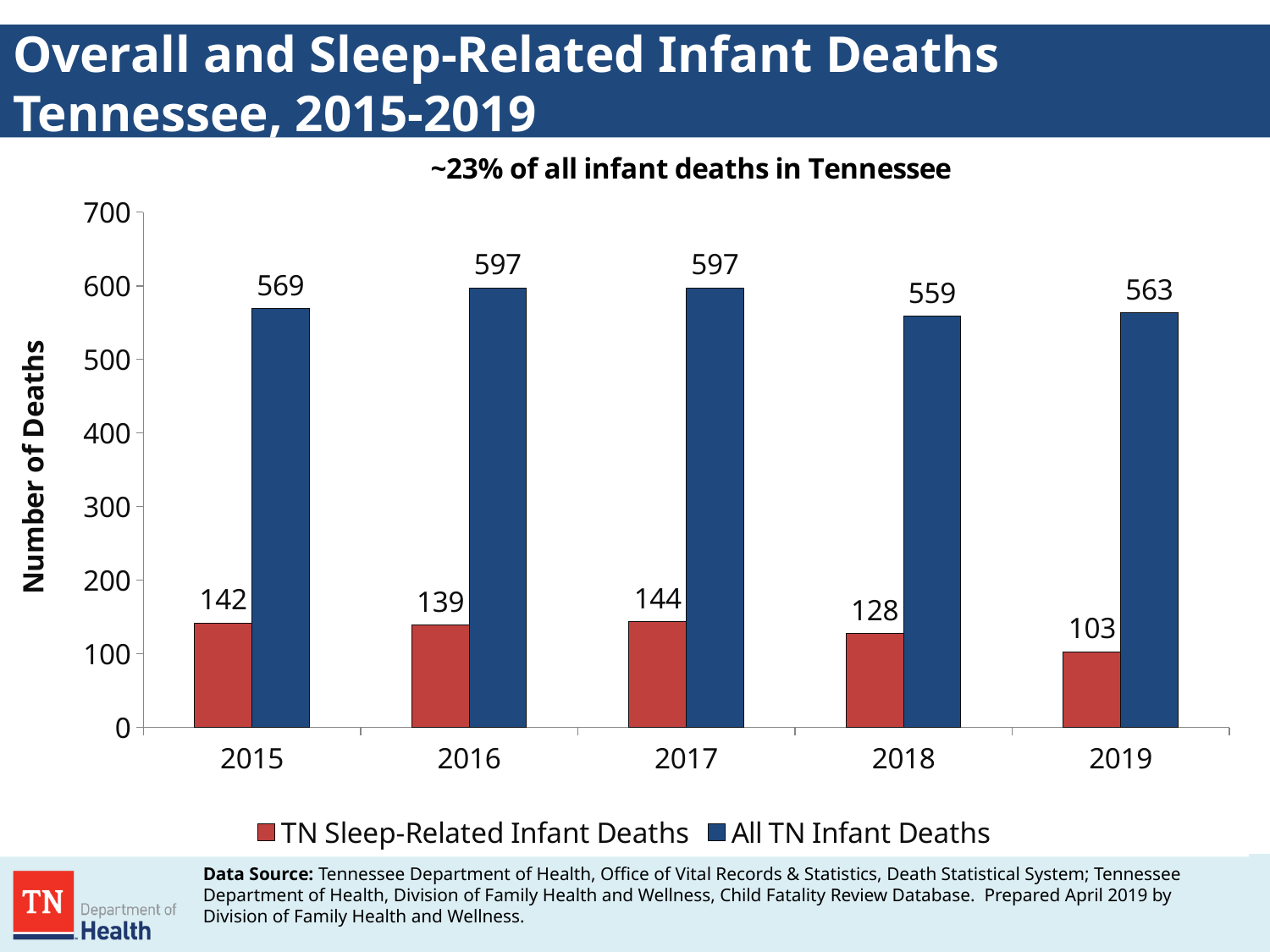
What is the value for TN Sleep-Related Infant Deaths in 2017? 144 Which year has the lowest value for All TN Infant Deaths? 2018 What is the label of the y axis? Number of Deaths Which is larger, All TN Infant Deaths in 2016 or in 2019? 2016 What is the value for TN Sleep-Related Infant Deaths in 2019? 103 How many series does the legend list? 2 What is the difference between TN Sleep-Related Infant Deaths in 2018 and 2019? 25 What kind of chart is shown on the slide? Bar chart What is the difference between All TN Infant Deaths and TN Sleep-Related Infant Deaths in 2015? 427 Which year has the lowest value for TN Sleep-Related Infant Deaths? 2019 How many years are shown on the x axis? 5 What is the value for All TN Infant Deaths in 2018? 559